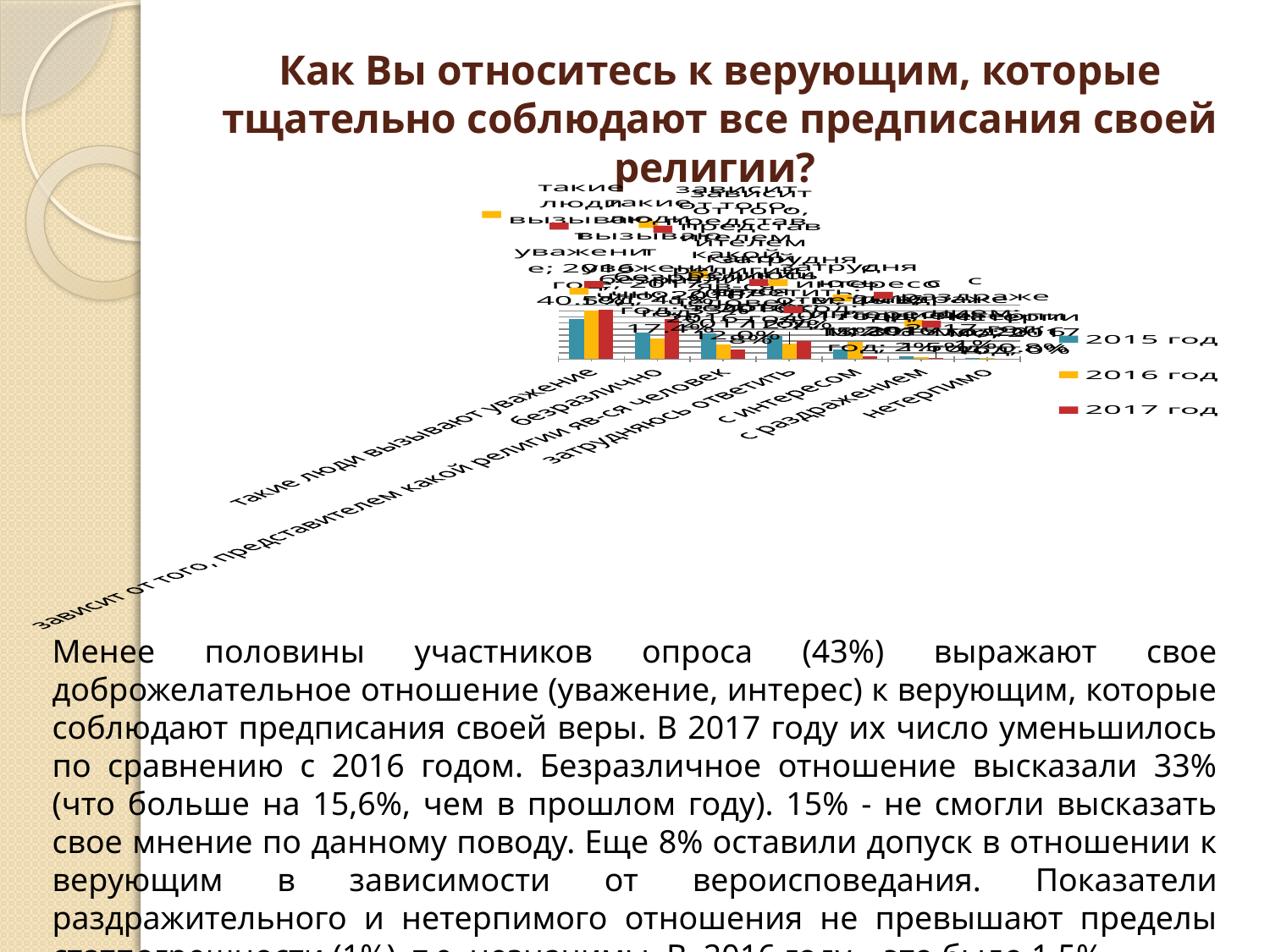
Which series is shown in red in the chart? 2017 год Which category has taller bars: 'затрудняюсь ответить' or 'нетерпимо'? затрудняюсь ответить Do the bar heights generally rise or fall moving from left to right along the x axis? fall What is the first category on the left of the x axis? такие люди вызывают уважение Which category has the tallest bars in the chart? такие люди вызывают уважение What kind of chart is shown on the slide? bar chart How many series does the chart legend list? 3 How many categories are shown along the x axis of the chart? 7 Which category has taller bars: 'такие люди вызывают уважение' or 'безразлично'? такие люди вызывают уважение Which years are listed in the chart legend? 2015 год, 2016 год, 2017 год